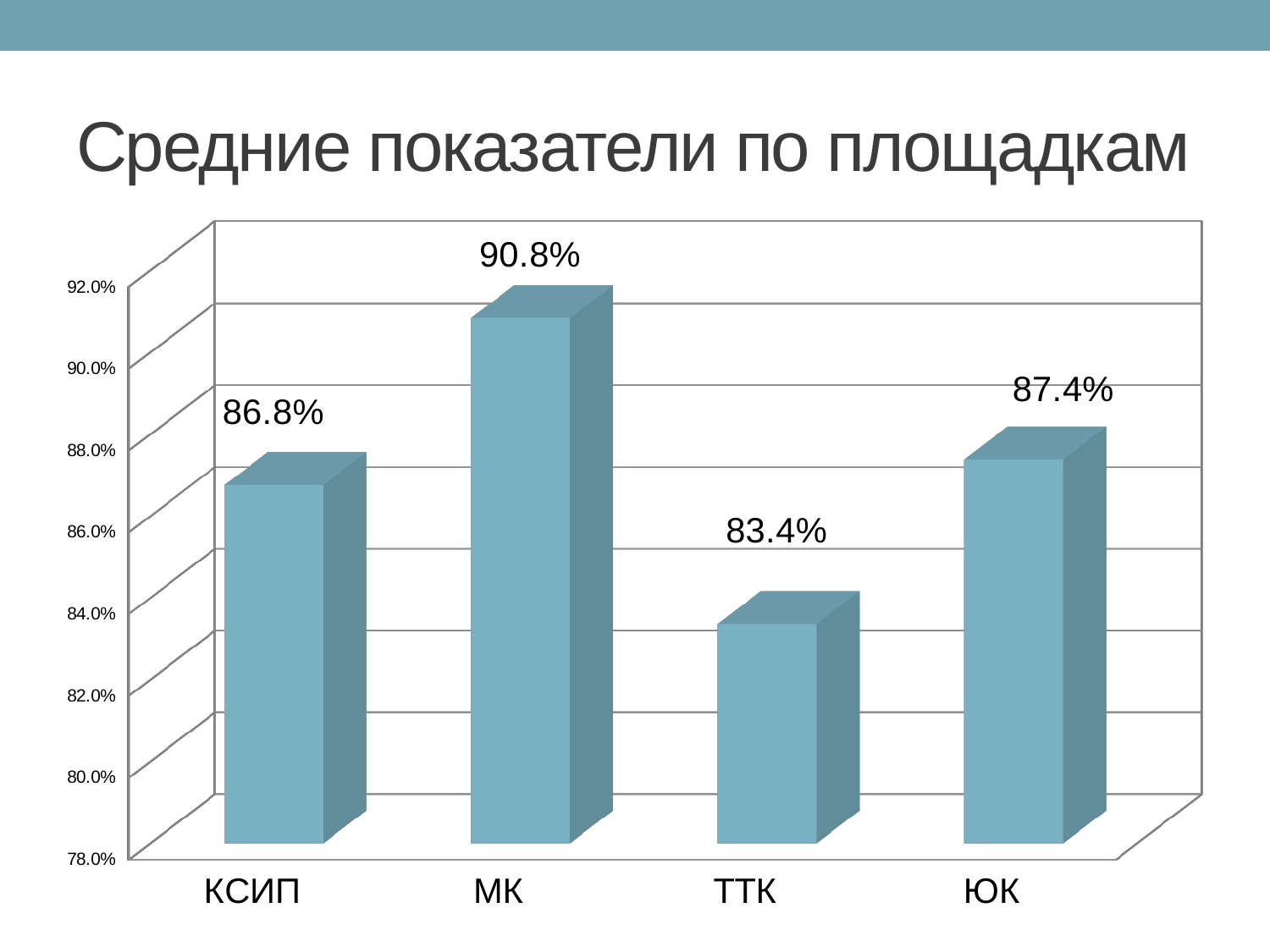
Which is larger, the value for КСИП or the value for ЮК? ЮК Is the value for ТТК greater or less than 84.0%? less What is the value for КСИП? 86.8% What kind of chart is shown on the slide? bar chart What is the value for ТТК? 83.4% What is the difference between the values for ЮК and КСИП? 0.6% Which category has the highest value? МК What is the value for МК? 90.8% Which category has the lowest value? ТТК What is the value for ЮК? 87.4% What is the difference between the values for МК and ТТК? 7.4% How many categories are shown on the chart? 4